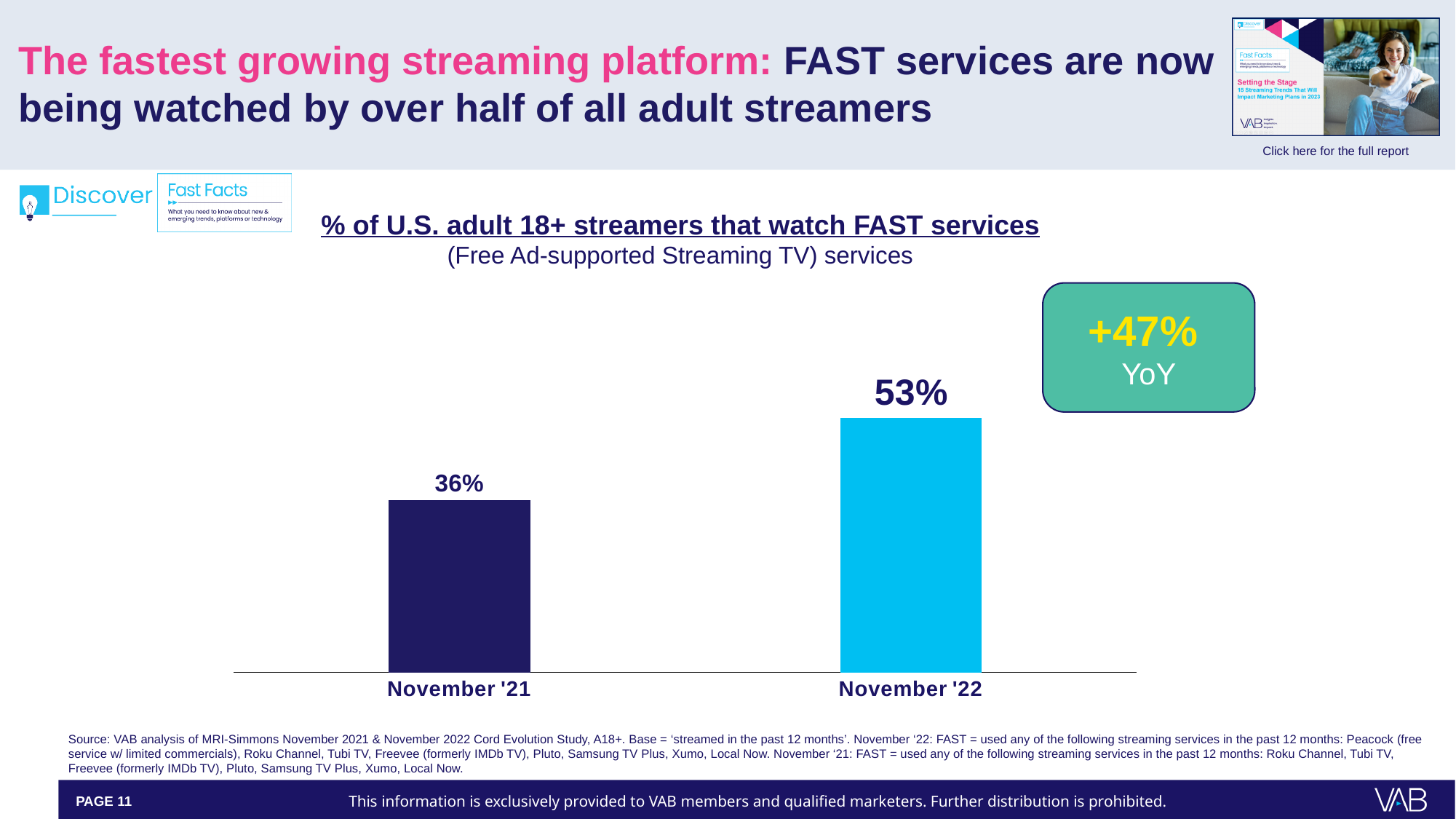
Is the value for November '22 larger or smaller than the value for November '21? larger Which period has the higher share of streamers watching FAST services? November '22 How many categories are shown on the x axis of the chart? 2 What percentage of U.S. adult 18+ streamers watched FAST services in November '21? 36% What is the difference in percentage points between November '22 and November '21? 17 What is the title of the chart? % of U.S. adult 18+ streamers that watch FAST services What percentage of U.S. adult 18+ streamers watched FAST services in November '22? 53% What kind of chart is shown on the slide? bar chart Do the values rise or fall from November '21 to November '22? rise Which period has the lower share of streamers watching FAST services? November '21 What year-over-year change is shown in the callout box next to the chart? +47%